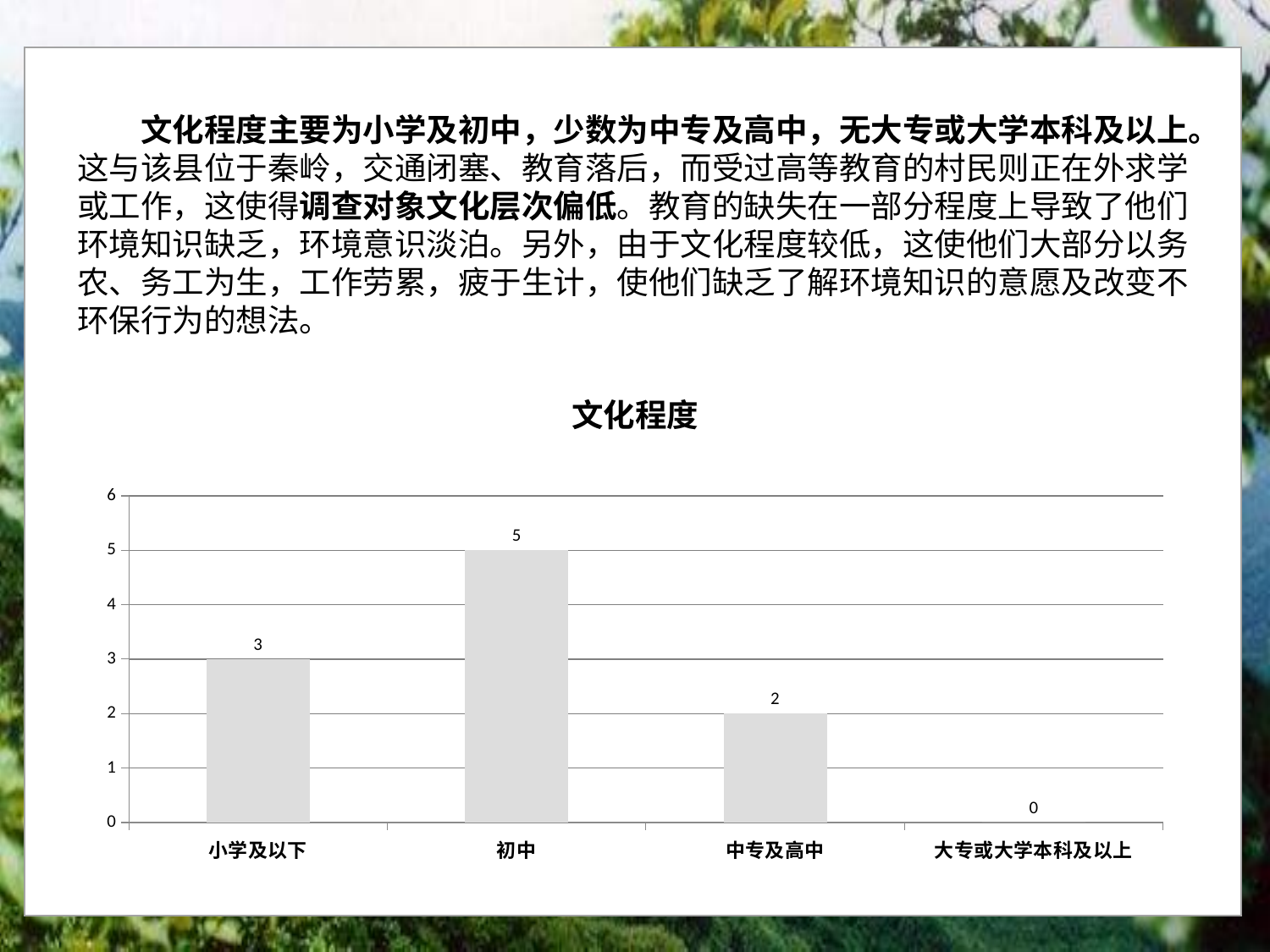
What is the value for 小学及以下 in the 文化程度 chart? 3 What is the title of the chart on the slide? 文化程度 Which category has the lowest value in the 文化程度 chart? 大专或大学本科及以上 What is the value for 中专及高中 in the 文化程度 chart? 2 What is the value for 初中 in the 文化程度 chart? 5 Which category has the highest value in the 文化程度 chart? 初中 Is the value for 初中 in the 文化程度 chart greater or less than 4? greater How many categories are shown in the 文化程度 chart? 4 What is the difference between the values for 初中 and 小学及以下 in the 文化程度 chart? 2 Which is larger in the 文化程度 chart, the value for 小学及以下 or the value for 中专及高中? 小学及以下 What is the value for 大专或大学本科及以上 in the 文化程度 chart? 0 What kind of chart is the 文化程度 chart? bar chart